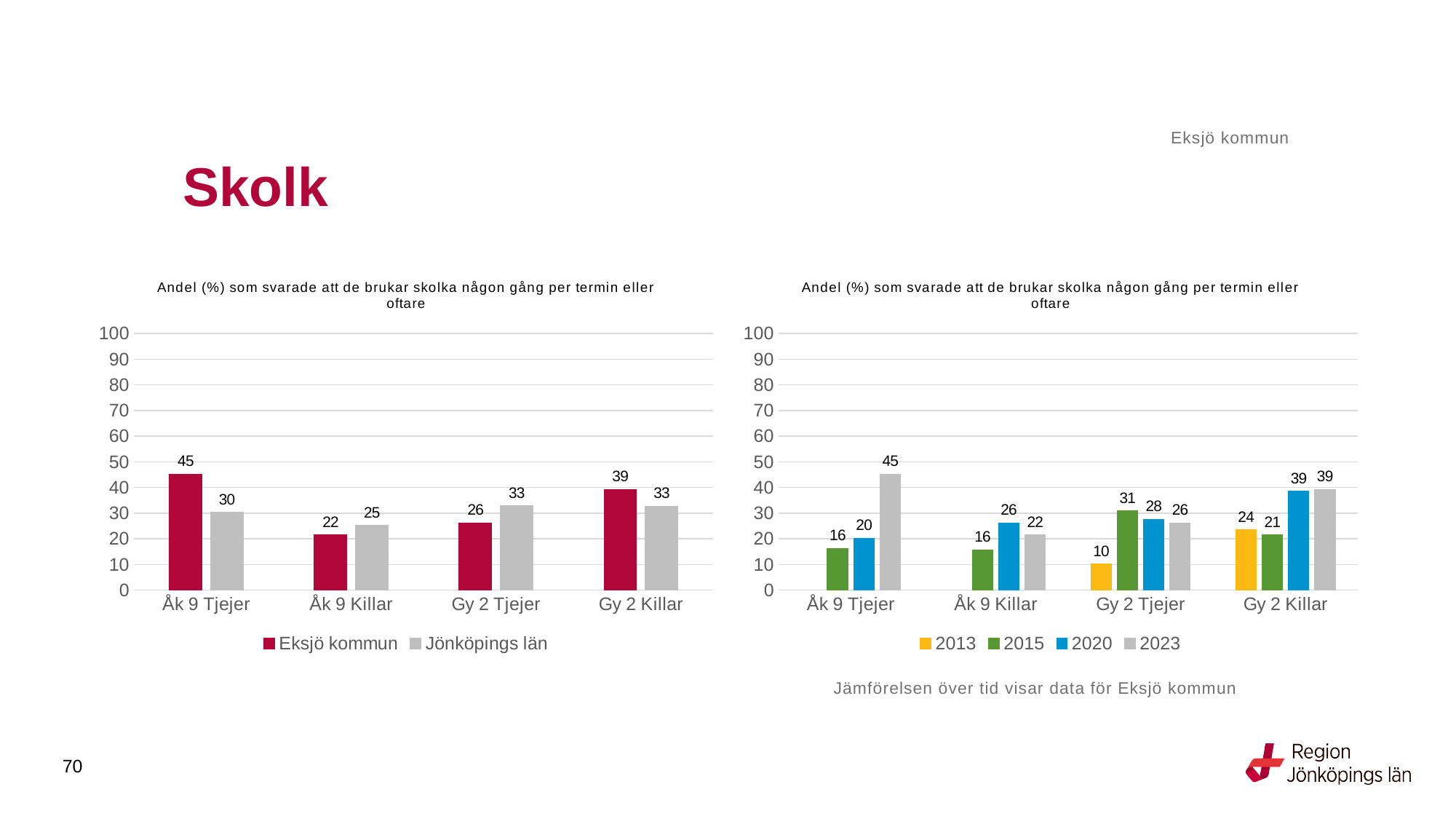
In the left chart, what is the difference between Eksjö kommun and Jönköpings län for Åk 9 Tjejer? 15 In the left chart, which is larger for Gy 2 Tjejer: Eksjö kommun or Jönköpings län? Jönköpings län How many series does the legend of the left chart list? 2 In the right chart, what is the value for 2013 for Gy 2 Tjejer? 10 In the left chart, what is the value for Eksjö kommun for Åk 9 Tjejer? 45 How many series does the legend of the right chart list? 4 In the right chart, what is the value for 2023 for Åk 9 Tjejer? 45 In the left chart, what is the value for Jönköpings län for Gy 2 Tjejer? 33 In the right chart, which year has the highest value for Åk 9 Killar? 2020 In the left chart, which category has the lowest value for Eksjö kommun? Åk 9 Killar In the right chart, what is the difference between 2020 and 2015 for Gy 2 Killar? 18 What kind of chart is the right chart? Bar chart